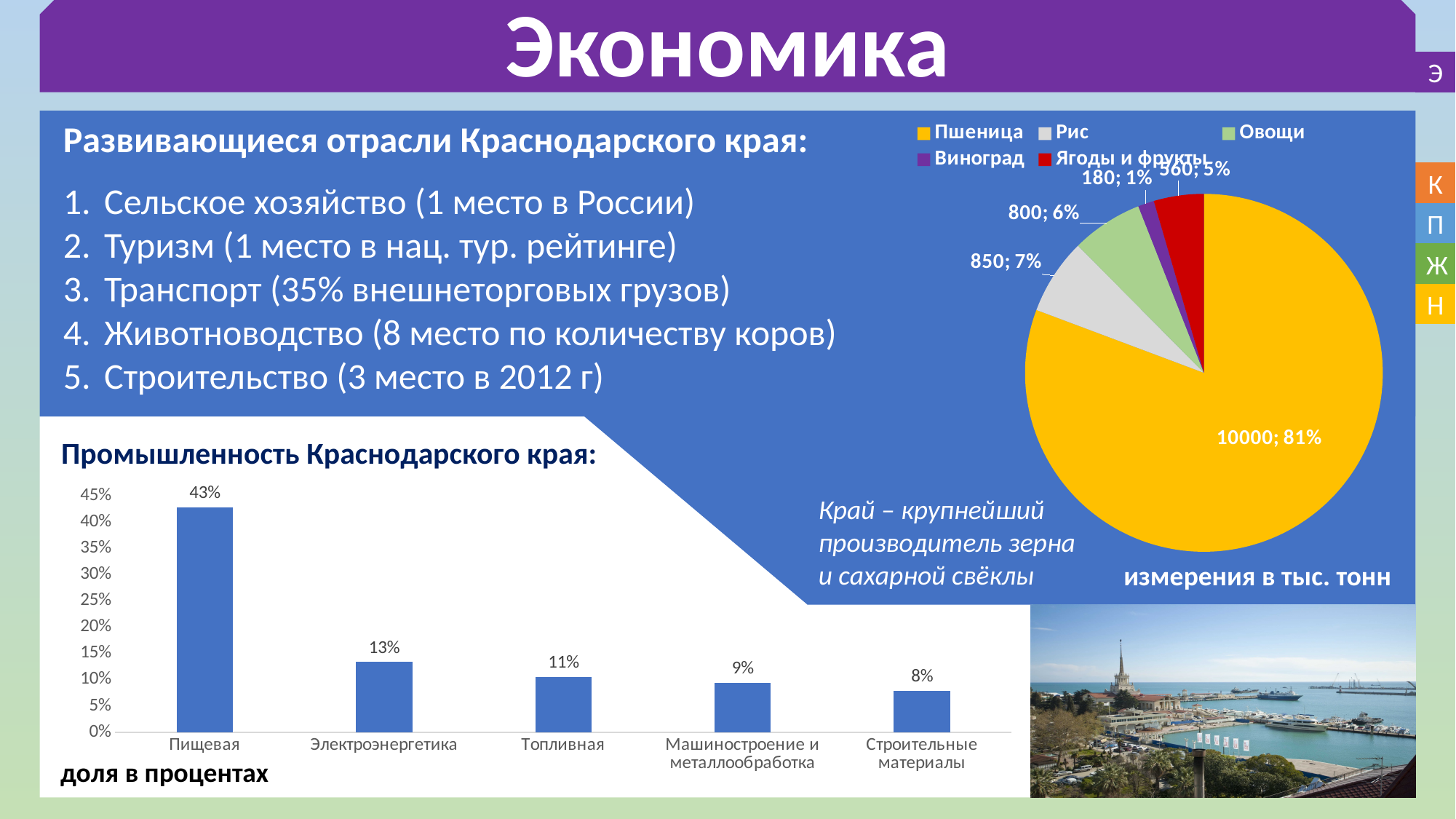
In the bar chart 'Промышленность Краснодарского края', which category has the lowest value? Строительные материалы In the bar chart 'Промышленность Краснодарского края', which category has the highest value? Пищевая In the pie chart on the right, what share does Рис have? 7% In the bar chart 'Промышленность Краснодарского края', which is larger: Электроэнергетика or Машиностроение и металлообработка? Электроэнергетика How many categories are shown in the bar chart 'Промышленность Краснодарского края'? 5 In the bar chart 'Промышленность Краснодарского края', what is the value for Пищевая? 43% In the pie chart on the right, what value is shown for Пшеница? 10000; 81% In the pie chart on the right, which category has the smallest slice? Виноград In the bar chart 'Промышленность Краснодарского края', what is the difference between Пищевая and Электроэнергетика? 30% What kind of chart is 'Промышленность Краснодарского края'? bar chart In the bar chart 'Промышленность Краснодарского края', what is the value for Топливная? 11% How many entries does the legend of the pie chart on the right list? 5